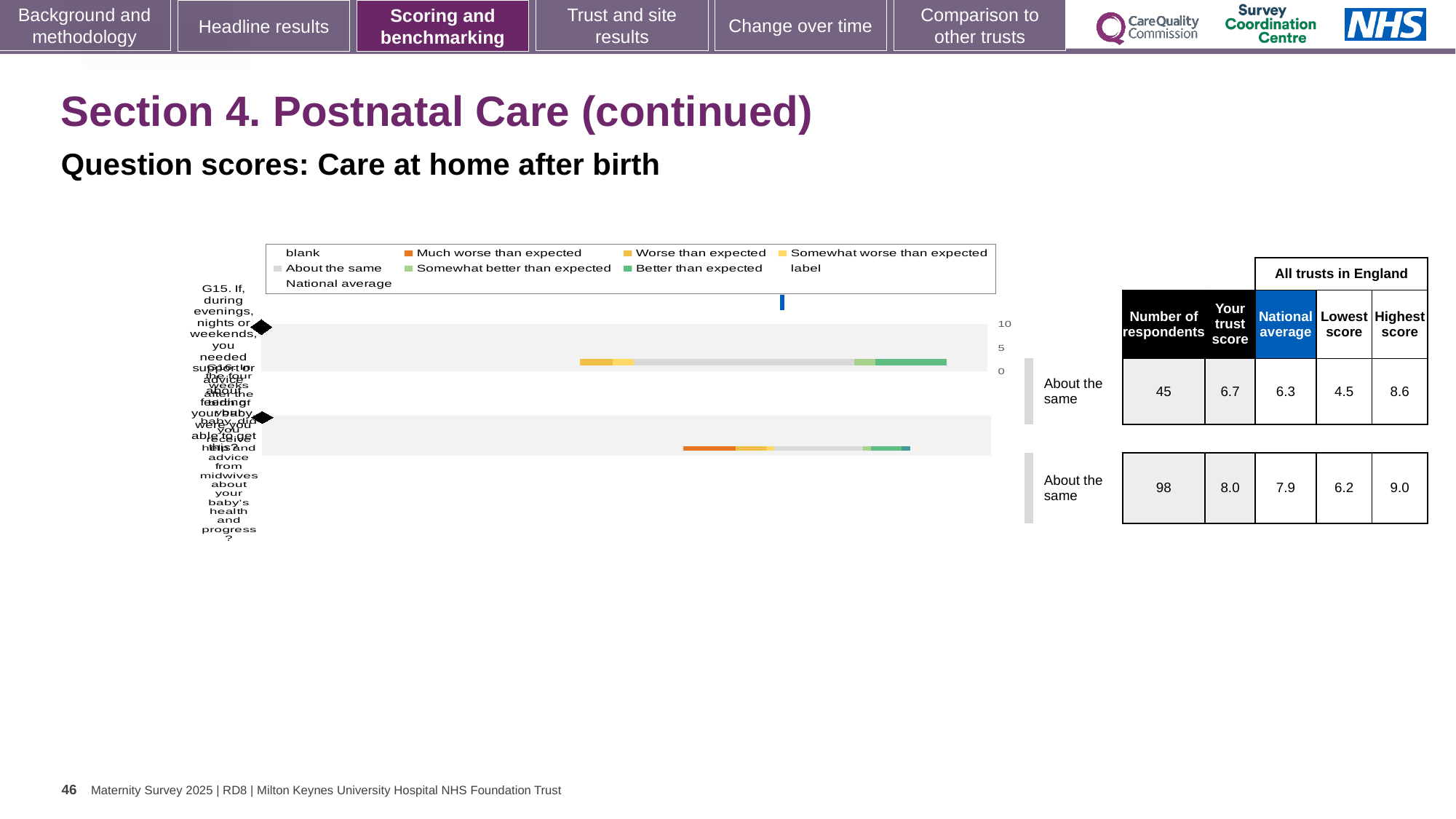
In the table beside the chart, what is the highest score for the bottom row? 9.0 In the table beside the chart, what is the national average for the top row? 6.3 In the table beside the chart, what is the difference between 'Your trust score' and the national average for the top row? 0.4 How many bars (question rows) does the chart show? 2 What benchmark label is shown next to the top bar of the chart? About the same In the table beside the chart, which row has more respondents, the top row or the bottom row? bottom row How many entries does the chart's legend list? 9 In the table beside the chart, what is 'Your trust score' for the bottom row? 8.0 In the chart's legend, what colour represents 'Much worse than expected'? orange In the table beside the chart, what is the difference between the highest score and the lowest score for the top row? 4.1 What kind of chart is shown on the slide? bar chart In the table beside the chart, what is the number of respondents for the top row? 45